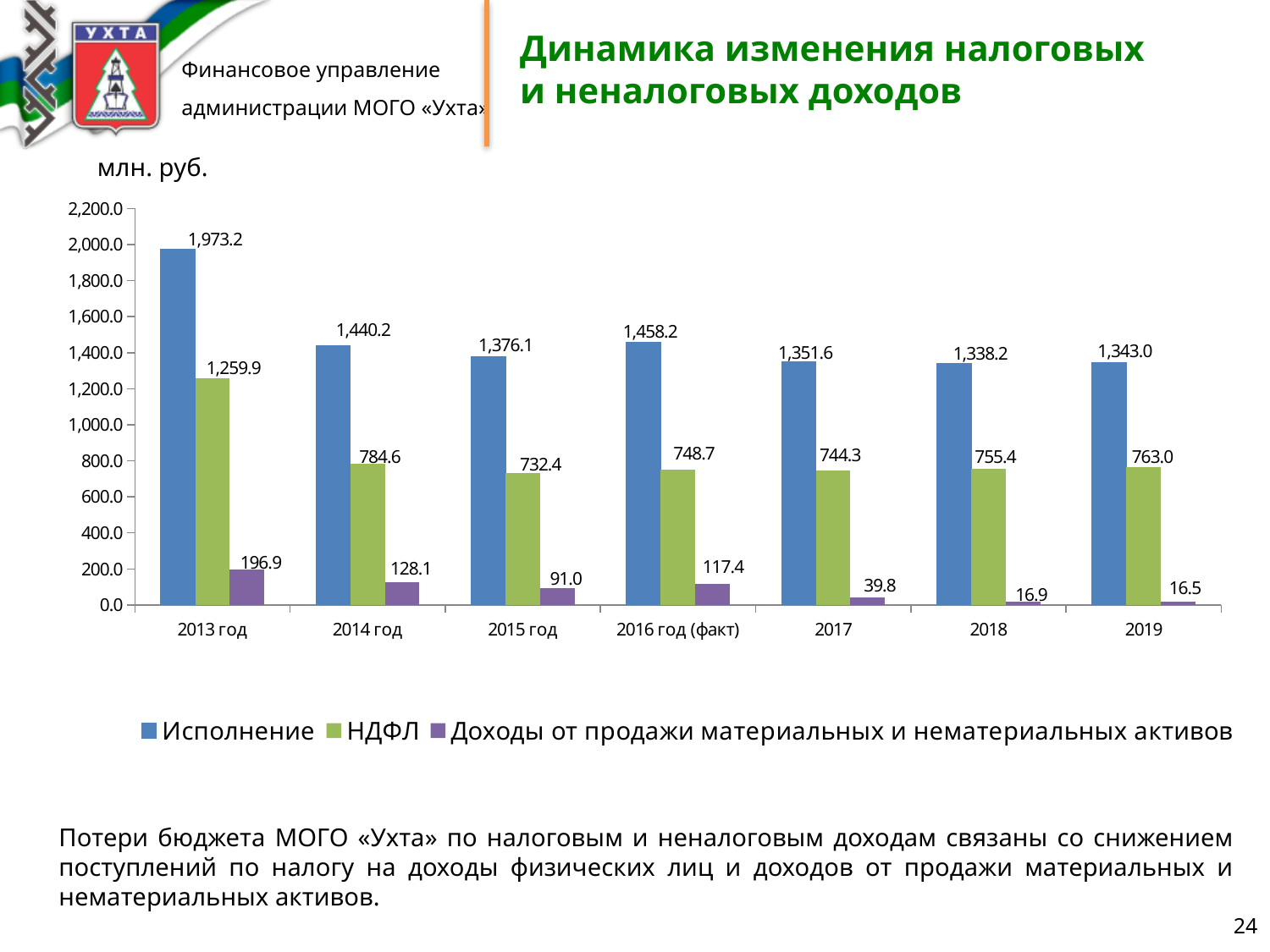
Which is larger: НДФЛ for 2018 or НДФЛ for 2015 год? 2018 How many year categories are shown on the x axis? 7 What is the value of НДФЛ for 2016 год (факт)? 748.7 In which year is the Доходы от продажи материальных и нематериальных активов value lowest? 2019 What is the difference between the Исполнение values for 2013 год and 2014 год? 533.0 What is the value of Доходы от продажи материальных и нематериальных активов for 2017? 39.8 What unit is indicated above the chart? млн. руб. How many series does the legend list? 3 What kind of chart is shown on the slide? bar chart What is the value of Исполнение for 2013 год? 1,973.2 Is the Исполнение value for 2016 год (факт) greater or less than 1,400.0? greater In which year is the Исполнение value highest? 2013 год